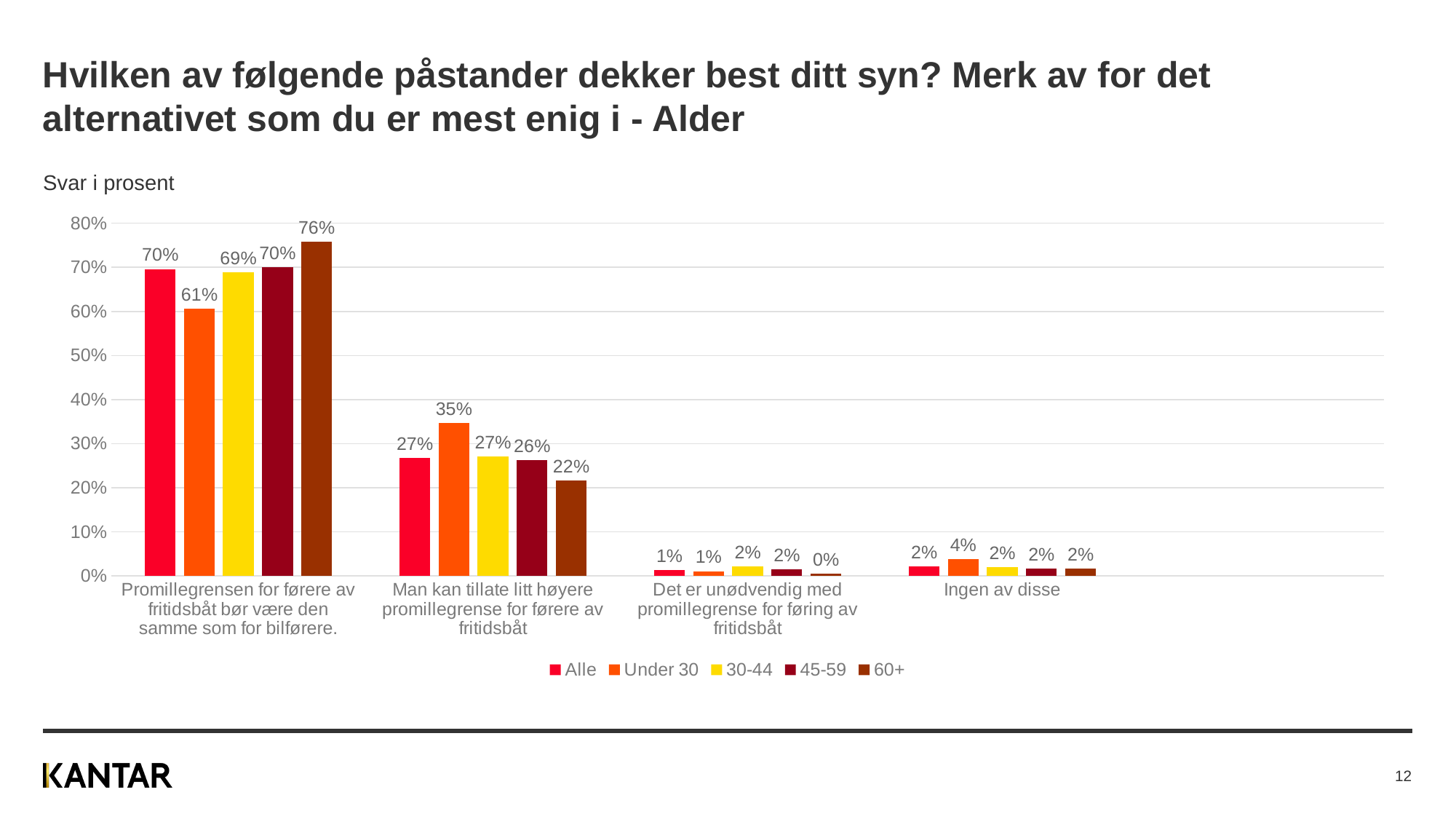
Which series has the lowest value in the category "Man kan tillate litt høyere promillegrense for førere av fritidsbåt"? 60+ What is the difference between the 60+ value and the Under 30 value in the category "Promillegrensen for førere av fritidsbåt bør være den samme som for bilførere."? 15 percentage points What is the subtitle shown above the chart? Svar i prosent What is the value for the Under 30 series in the category "Man kan tillate litt høyere promillegrense for førere av fritidsbåt"? 35% How many series does the legend list? 5 What is the value for the 60+ series in the category "Promillegrensen for førere av fritidsbåt bør være den samme som for bilførere."? 76% Which age series has the highest value in the category "Promillegrensen for førere av fritidsbåt bør være den samme som for bilførere."? 60+ What kind of chart is shown on the slide? Bar chart How many answer categories are shown on the x axis? 4 What is the value for the 60+ series in the category "Det er unødvendig med promillegrense for føring av fritidsbåt"? 0% Which is larger: the Under 30 value or the 45-59 value in the category "Man kan tillate litt høyere promillegrense for førere av fritidsbåt"? Under 30 What is the value for the Alle series in the category "Ingen av disse"? 2%